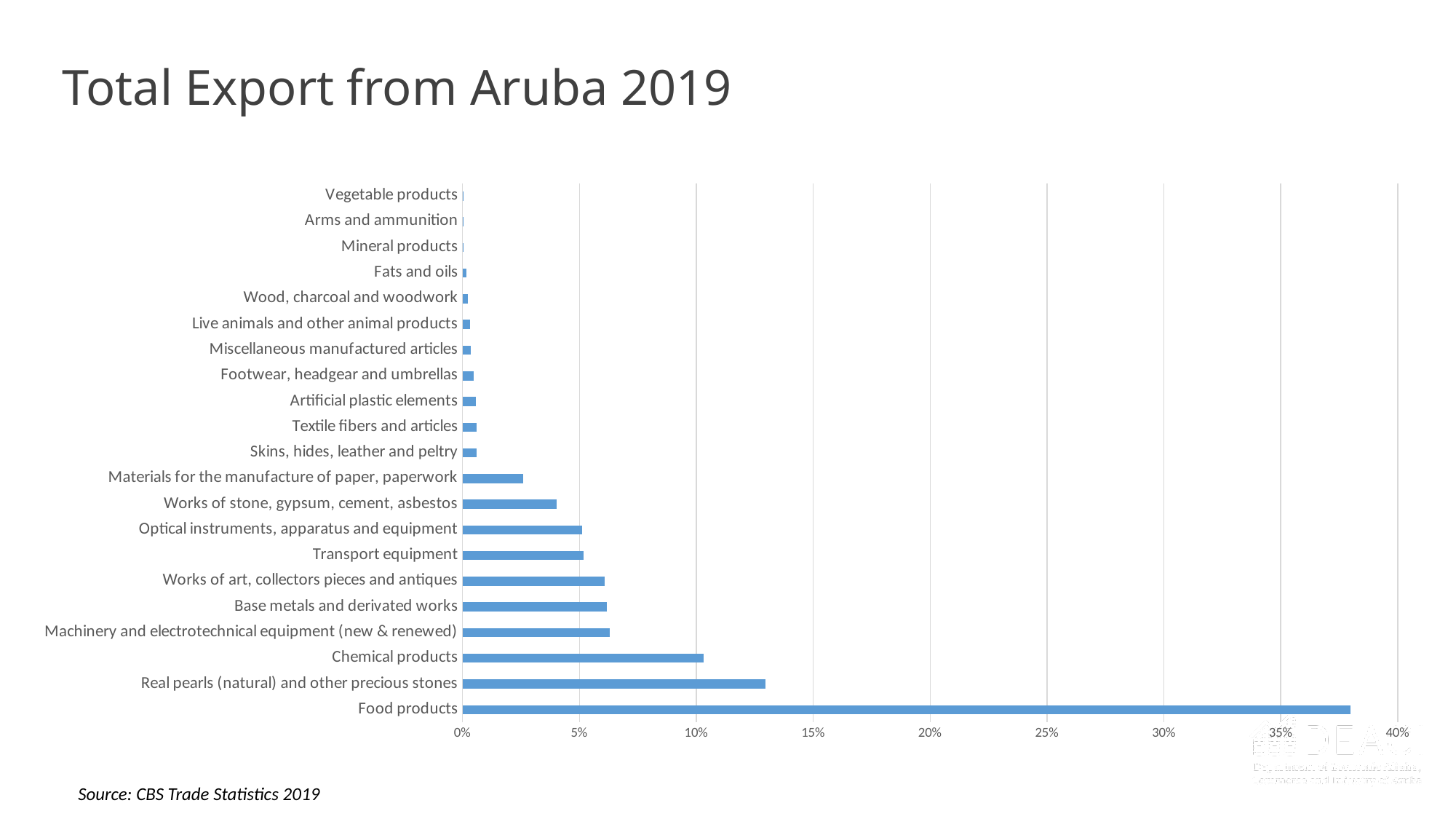
Is the value for Food products greater or less than 35%? greater Is the value for Real pearls (natural) and other precious stones greater or less than 10%? greater Which is larger, the value for Works of stone, gypsum, cement, asbestos or the value for Materials for the manufacture of paper, paperwork? Works of stone, gypsum, cement, asbestos How many product categories are shown in the chart? 21 What kind of chart is shown on the slide? bar chart Which category has the highest export share? Food products Is the value for Machinery and electrotechnical equipment (new & renewed) greater or less than 5%? greater What source is cited for the chart data? CBS Trade Statistics 2019 What is the title of the chart? Total Export from Aruba 2019 Which is larger, the value for Real pearls (natural) and other precious stones or the value for Chemical products? Real pearls (natural) and other precious stones